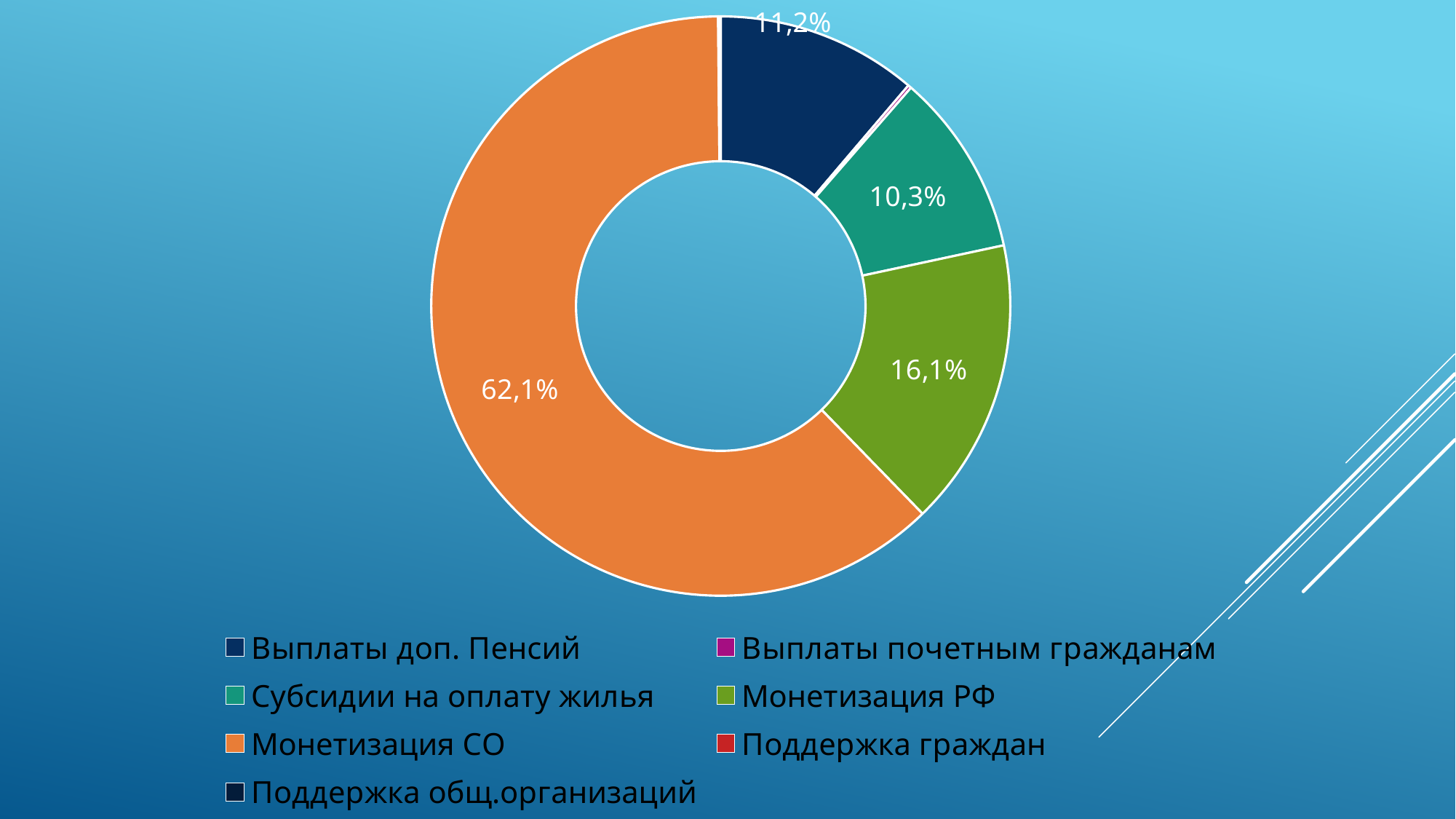
Which category has the largest slice of the chart? Монетизация СО What percentage is shown for Монетизация РФ? 16,1% What percentage is shown for Субсидии на оплату жилья? 10,3% Is the share for Монетизация СО greater or less than 50%? greater What kind of chart is shown on the slide? Doughnut (pie) chart What share of the doughnut chart does Монетизация СО account for? 62,1% By how many percentage points does Монетизация РФ exceed Субсидии на оплату жилья? 5,8 Which is larger, the slice for Выплаты доп. Пенсий or the slice for Субсидии на оплату жилья? Выплаты доп. Пенсий Which is larger, the slice for Монетизация РФ or the slice for Субсидии на оплату жилья? Монетизация РФ How many categories does the legend list? 7 What colour is the slice for Монетизация СО? Orange What percentage is shown for Выплаты доп. Пенсий? 11,2%